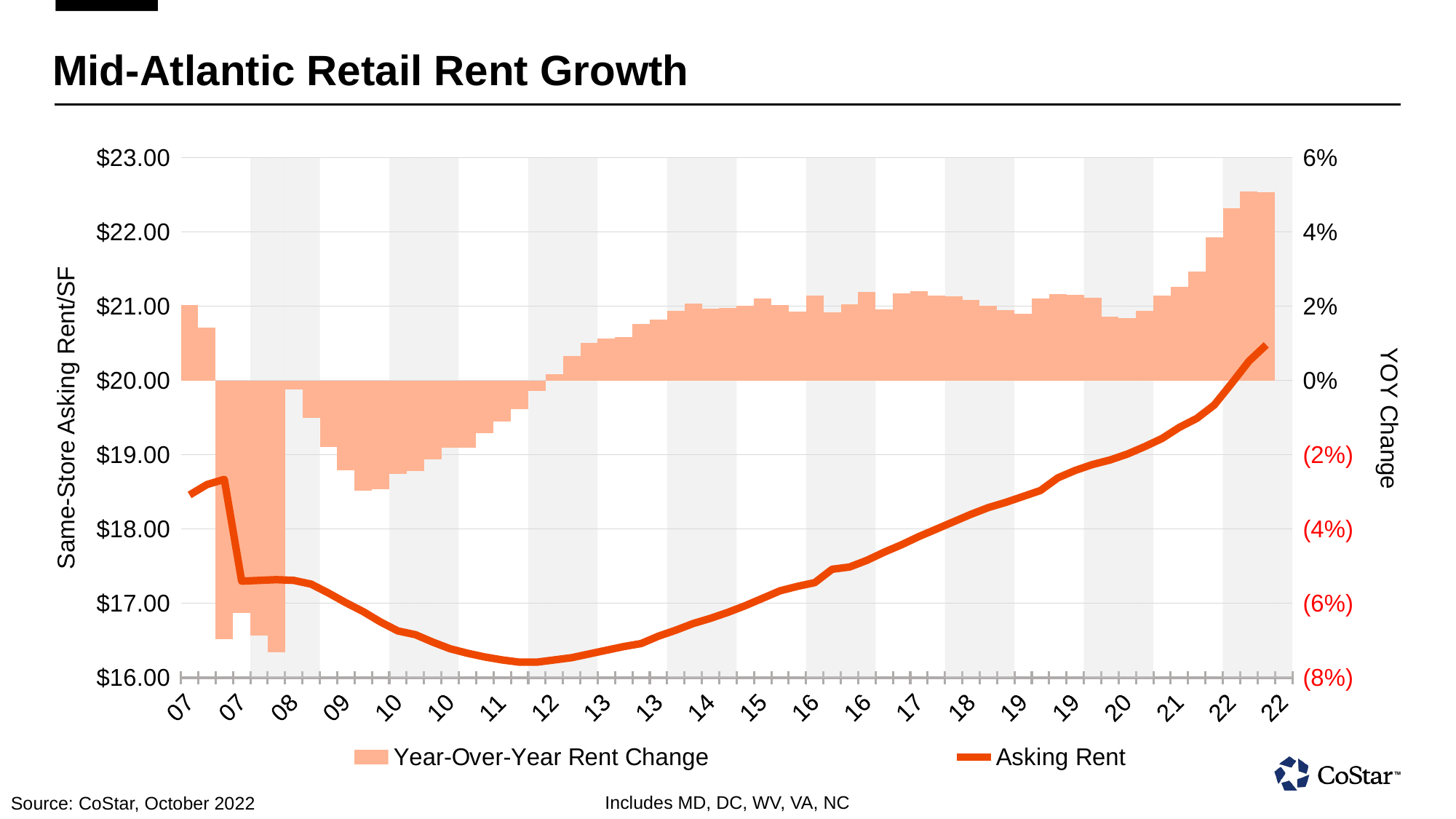
Is the Year-Over-Year Rent Change in 2009 greater or less than 0%? less Is the Asking Rent at the end of 2022 greater or less than $20.00? greater What kind of chart is this? Combination bar and line chart Is the Asking Rent around 2012 greater or less than $17.00? less What are the two series named in the legend? Year-Over-Year Rent Change and Asking Rent How many series does the legend list? 2 What is the title of the chart? Mid-Atlantic Retail Rent Growth Is the Asking Rent higher in 2022 or in 2012? 2022 Does the Asking Rent line rise or fall from 2012 to 2022? rise In which year does the Year-Over-Year Rent Change reach its highest value? 2022